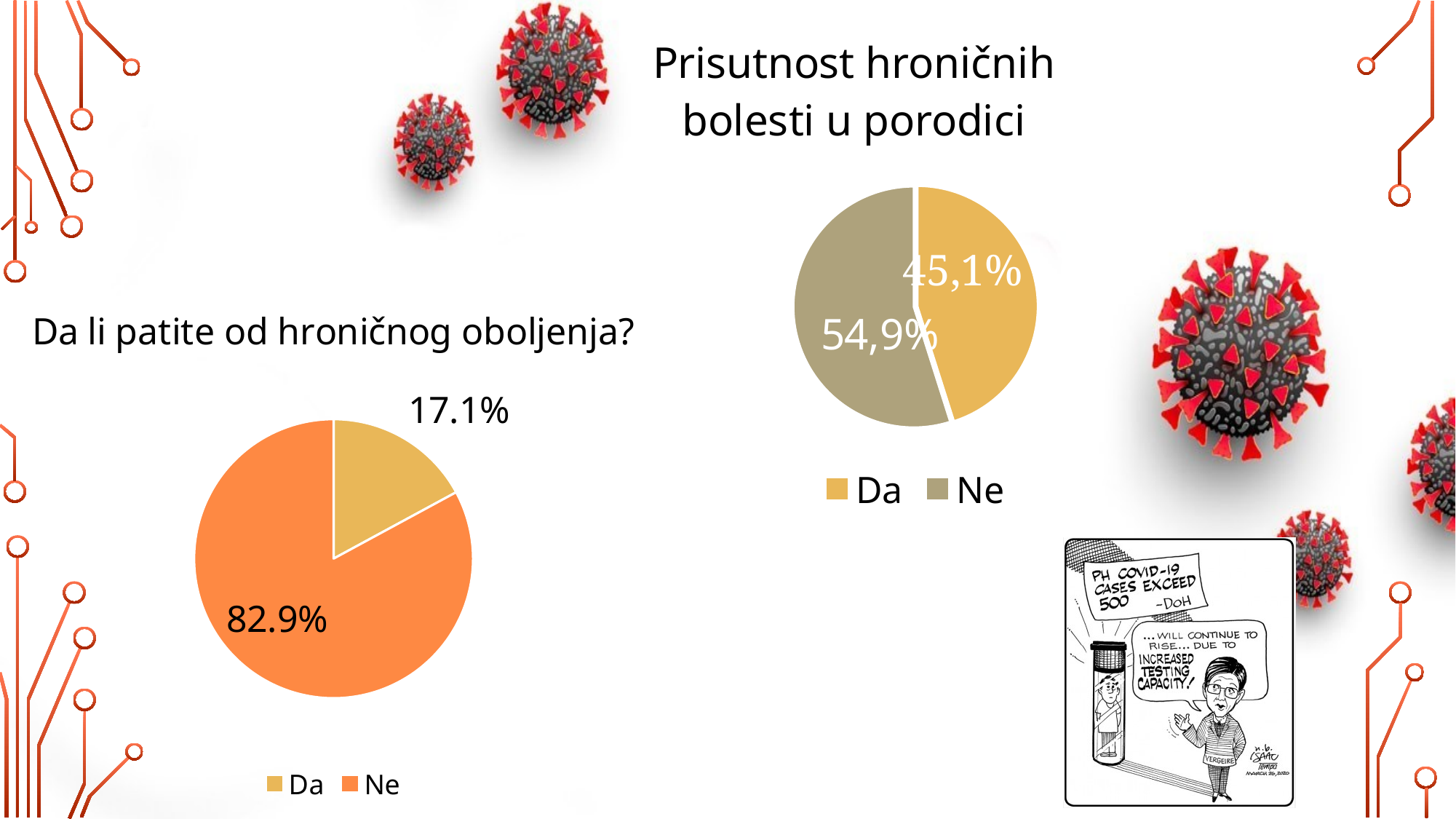
In the chart titled "Da li patite od hroničnog oboljenja?", which category has the largest slice? Ne In the chart titled "Prisutnost hroničnih bolesti u porodici", what is the difference between the Ne and Da percentages? 9,8% In the chart titled "Prisutnost hroničnih bolesti u porodici", what percentage is shown for Da? 45,1% In the chart titled "Prisutnost hroničnih bolesti u porodici", which category has the smallest slice? Da In the chart titled "Prisutnost hroničnih bolesti u porodici", what percentage is shown for Ne? 54,9% In the chart titled "Da li patite od hroničnog oboljenja?", what percentage is shown for Ne? 82.9% In the chart titled "Prisutnost hroničnih bolesti u porodici", which is larger, Da or Ne? Ne In the chart titled "Da li patite od hroničnog oboljenja?", what is the difference between the Ne and Da percentages? 65.8% In the chart titled "Da li patite od hroničnog oboljenja?", what percentage is shown for Da? 17.1% What type of chart is used for "Da li patite od hroničnog oboljenja?"? Pie chart How many categories does the legend of the chart titled "Prisutnost hroničnih bolesti u porodici" list? 2 In the chart titled "Da li patite od hroničnog oboljenja?", what colour is the Ne slice? Orange